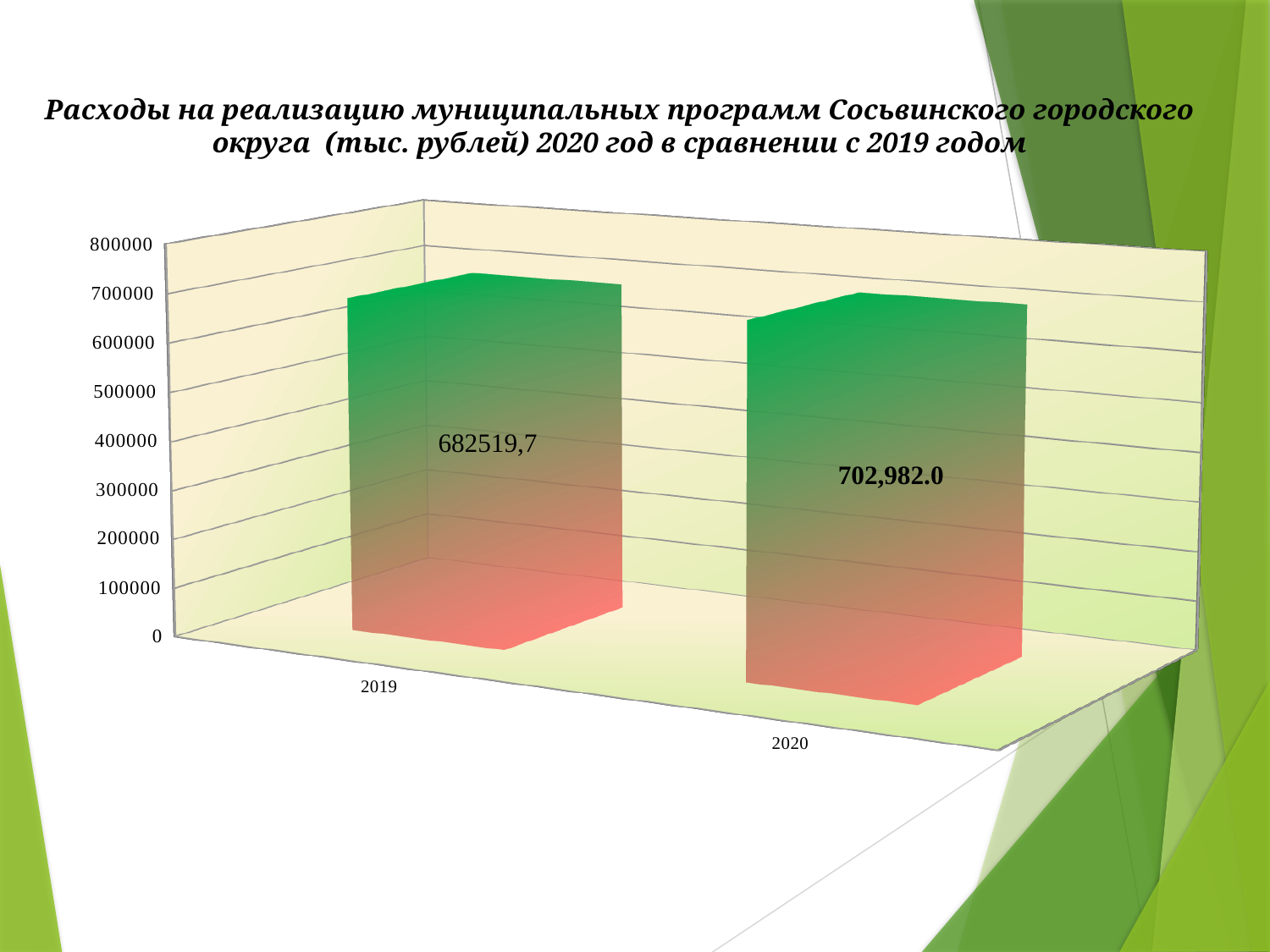
In what units are the expenses given according to the slide title? тыс. рублей How many years are shown on the chart? 2 What is the value for 2020? 702,982.0 Which year has the higher value? 2020 What kind of chart is shown on the slide? Bar chart Is the value for 2020 greater or less than 800000? less Is the value for 2019 greater or less than 600000? greater Do the values rise or fall from 2019 to 2020? Rise Which year has the lower value? 2019 What is the value for 2019? 682519,7 What is the maximum value shown on the vertical axis? 800000 Is the value for 2020 larger than the value for 2019? Yes